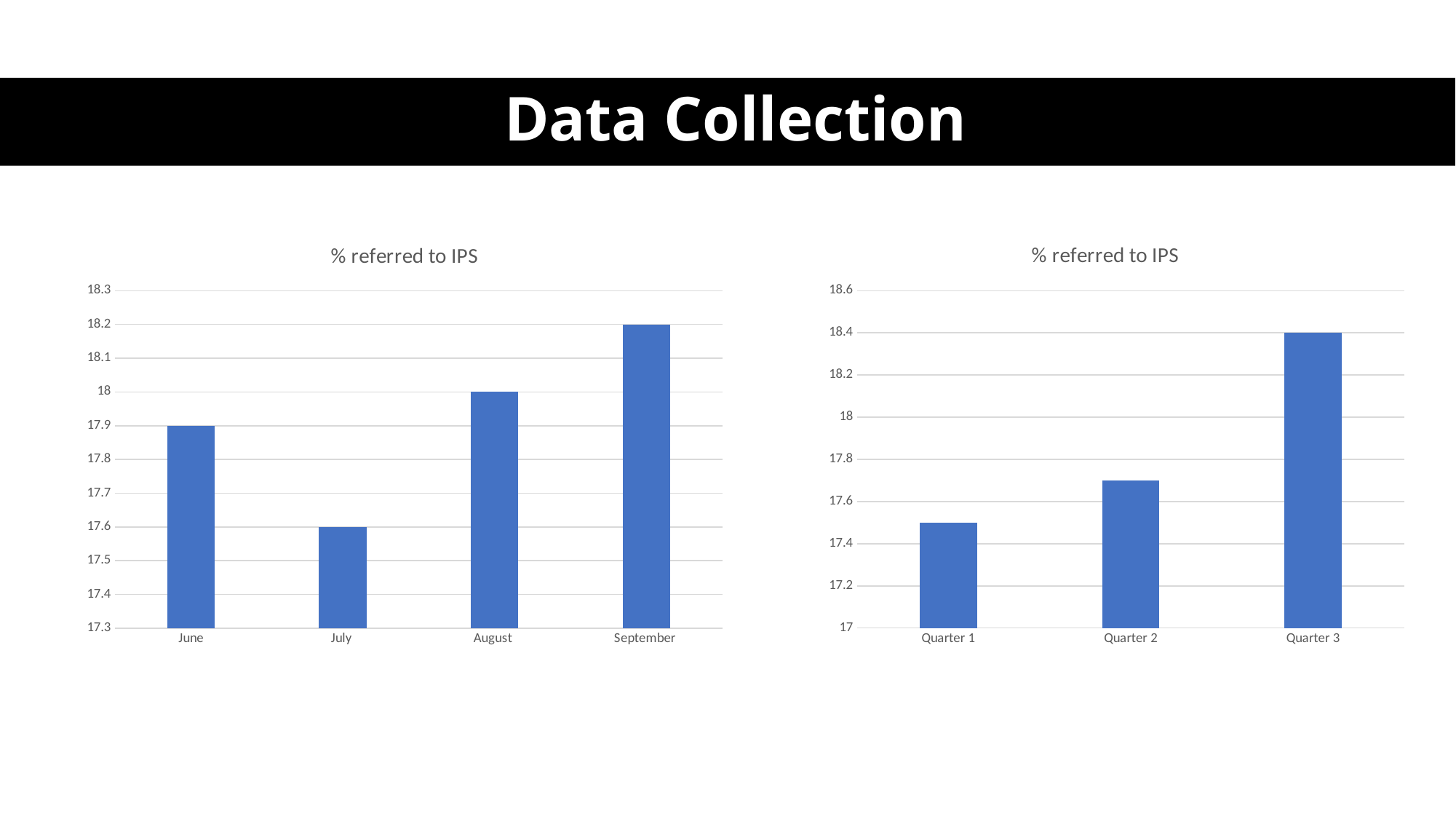
On the left chart, which month has the highest value? September On the left chart, what is the value for July? 17.6 On the left chart, what is the value for September? 18.2 On the right chart, is the value for Quarter 2 greater or less than 17.6? greater On the right chart, is the value for Quarter 1 greater or less than 17.6? less On the left chart, how many months are shown on the x axis? 4 On the right chart, which quarter has the highest value? Quarter 3 On the right chart, do the values rise or fall from Quarter 1 to Quarter 3? rise On the left chart, which month has the lowest value? July On the left chart, what is the difference between the values for September and June? 0.3 What type of chart is the right chart? bar chart On the left chart, what is the value for August? 18